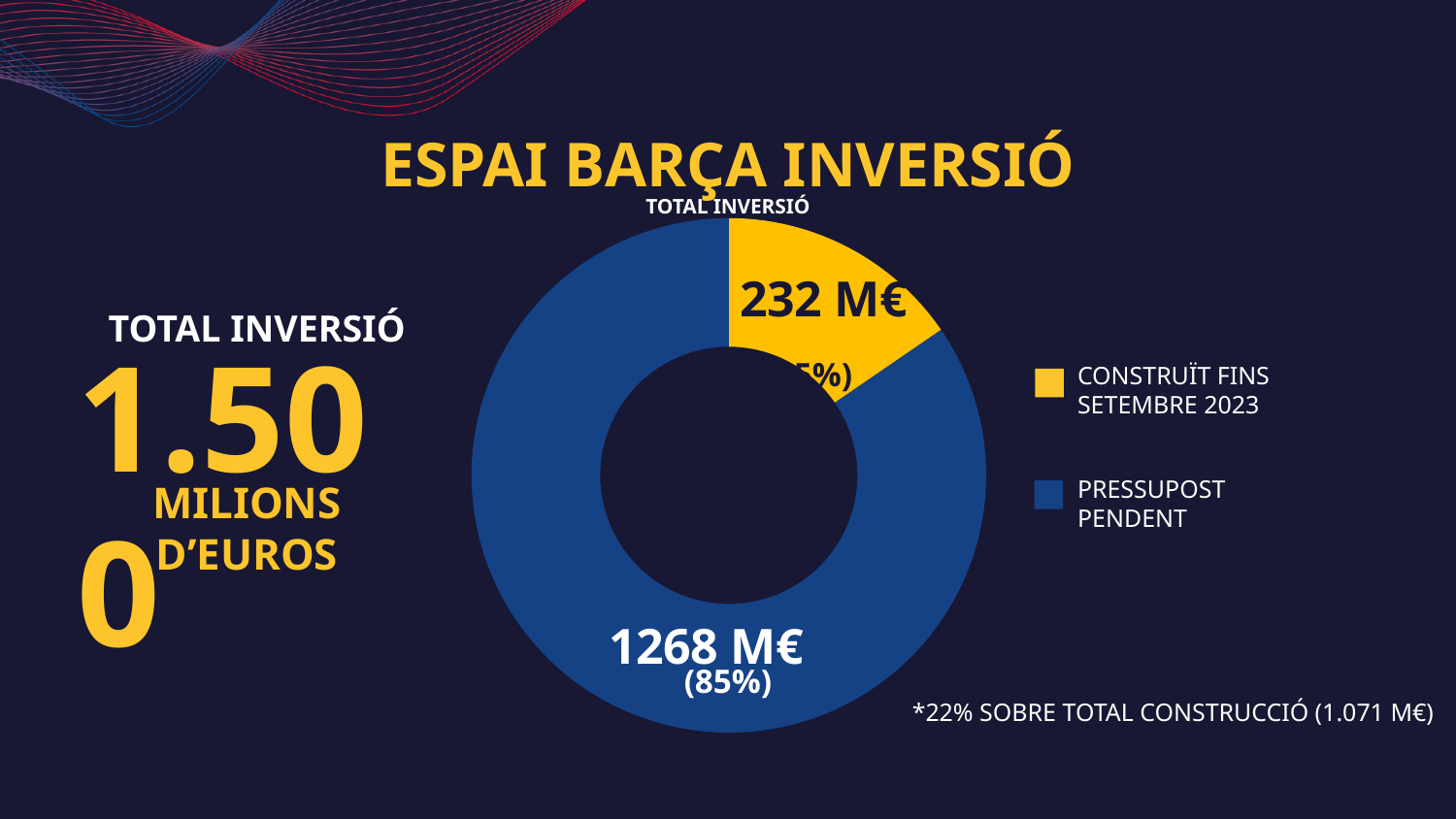
Which colour represents PRESSUPOST PENDENT in the chart? Blue What is the title of the chart? TOTAL INVERSIÓ What share of the chart does PRESSUPOST PENDENT represent? 85% What is the difference between PRESSUPOST PENDENT and CONSTRUÏT FINS SETEMBRE 2023? 1036 M€ What is the value for PRESSUPOST PENDENT? 1268 M€ What is the value for CONSTRUÏT FINS SETEMBRE 2023? 232 M€ Which is larger, CONSTRUÏT FINS SETEMBRE 2023 or PRESSUPOST PENDENT? PRESSUPOST PENDENT How many slices does the chart have? 2 Which slice is the smallest? CONSTRUÏT FINS SETEMBRE 2023 How many series does the legend list? 2 What kind of chart is shown on the slide? Pie chart (donut) Which slice is the largest? PRESSUPOST PENDENT